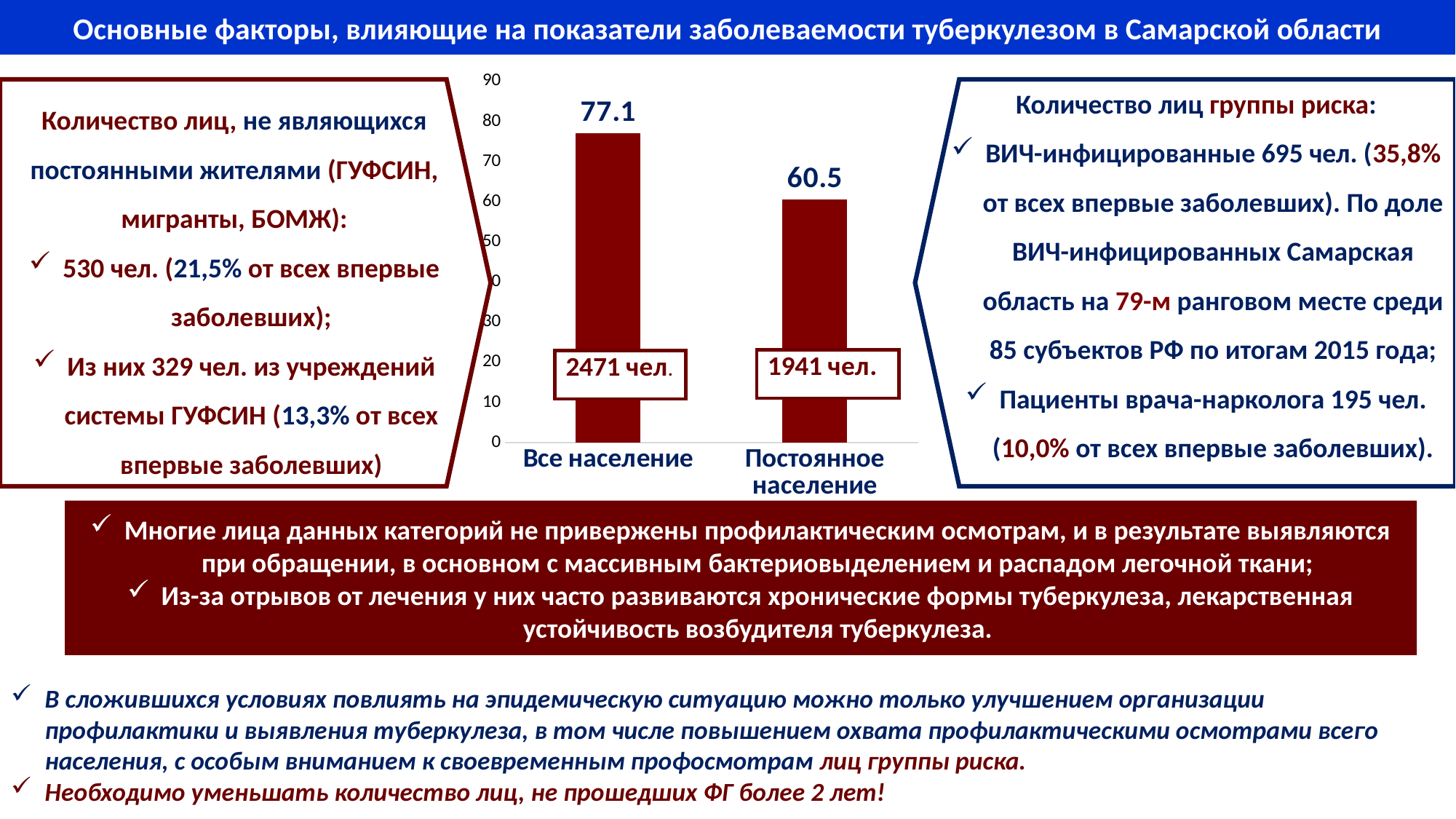
Which category has the higher value? Все население What is the value shown for "Все население"? 77.1 What kind of chart is shown on the slide? bar chart Is the value for "Все население" larger or smaller than the value for "Постоянное население"? larger What number of people is labelled on the bar for "Все население"? 2471 чел. Which category has the lower value? Постоянное население What number of people is labelled on the bar for "Постоянное население"? 1941 чел. What is the difference between the values for "Все население" and "Постоянное население"? 16.6 How many categories are shown on the chart? 2 What is the value shown for "Постоянное население"? 60.5 Is the value for "Все население" greater or less than 70? greater Is the value for "Постоянное население" greater or less than 70? less